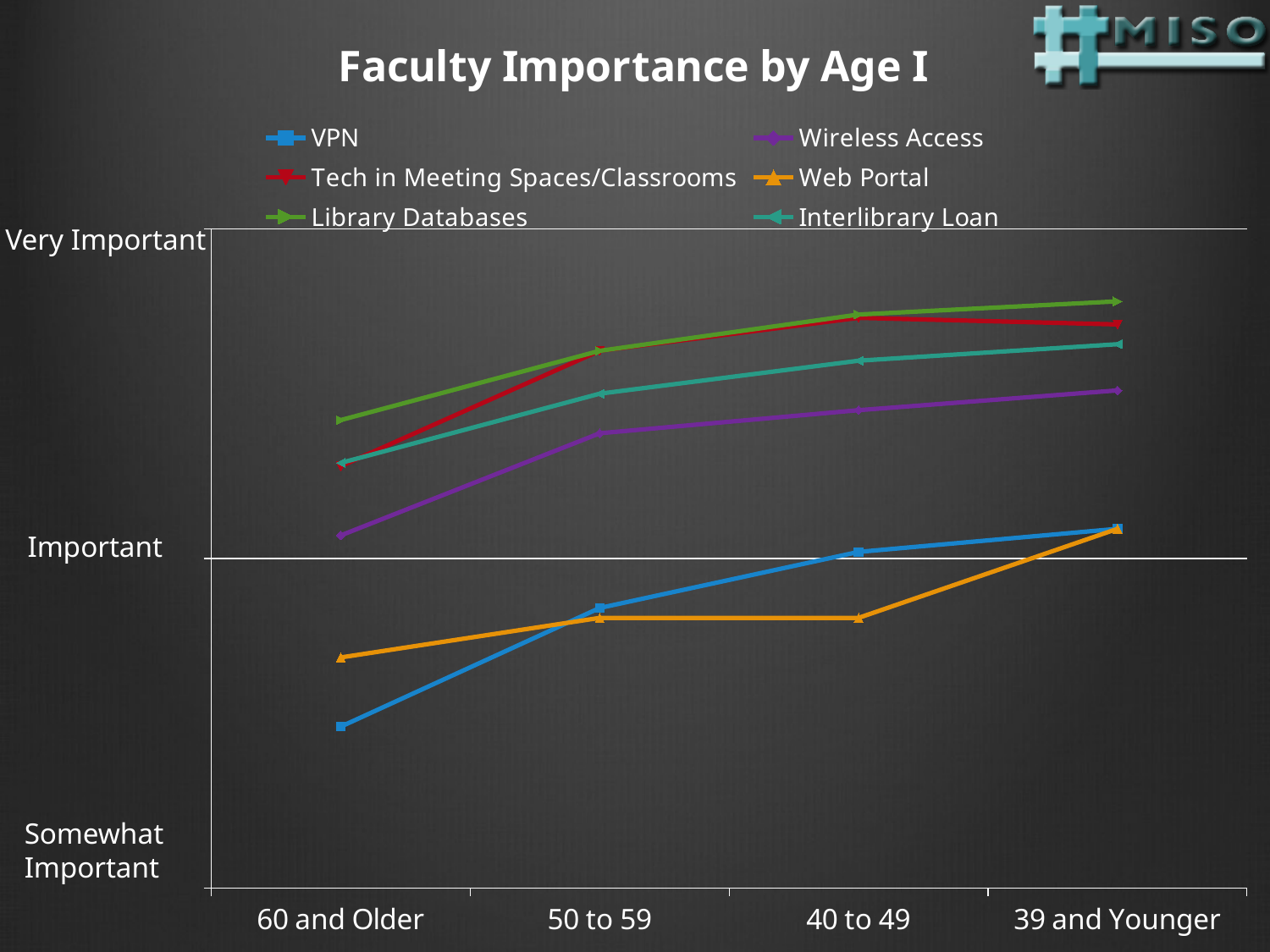
Which series has the highest value for the 60 and Older group? Library Databases For the 40 to 49 group, which is higher: Interlibrary Loan or Wireless Access? Interlibrary Loan For the 40 to 49 group, which is higher: VPN or Web Portal? VPN How many age categories are shown on the x axis? 4 Which series has the lowest value for the 40 to 49 group? Web Portal Which series has the highest value for the 39 and Younger group? Library Databases What is the title of the chart? Faculty Importance by Age I What kind of chart is shown on the slide? line chart Does the VPN line rise or fall from 60 and Older to 39 and Younger? rise Which series is shown in orange in the legend? Web Portal How many series does the legend list? 6 Which series has the lowest value for the 60 and Older group? VPN